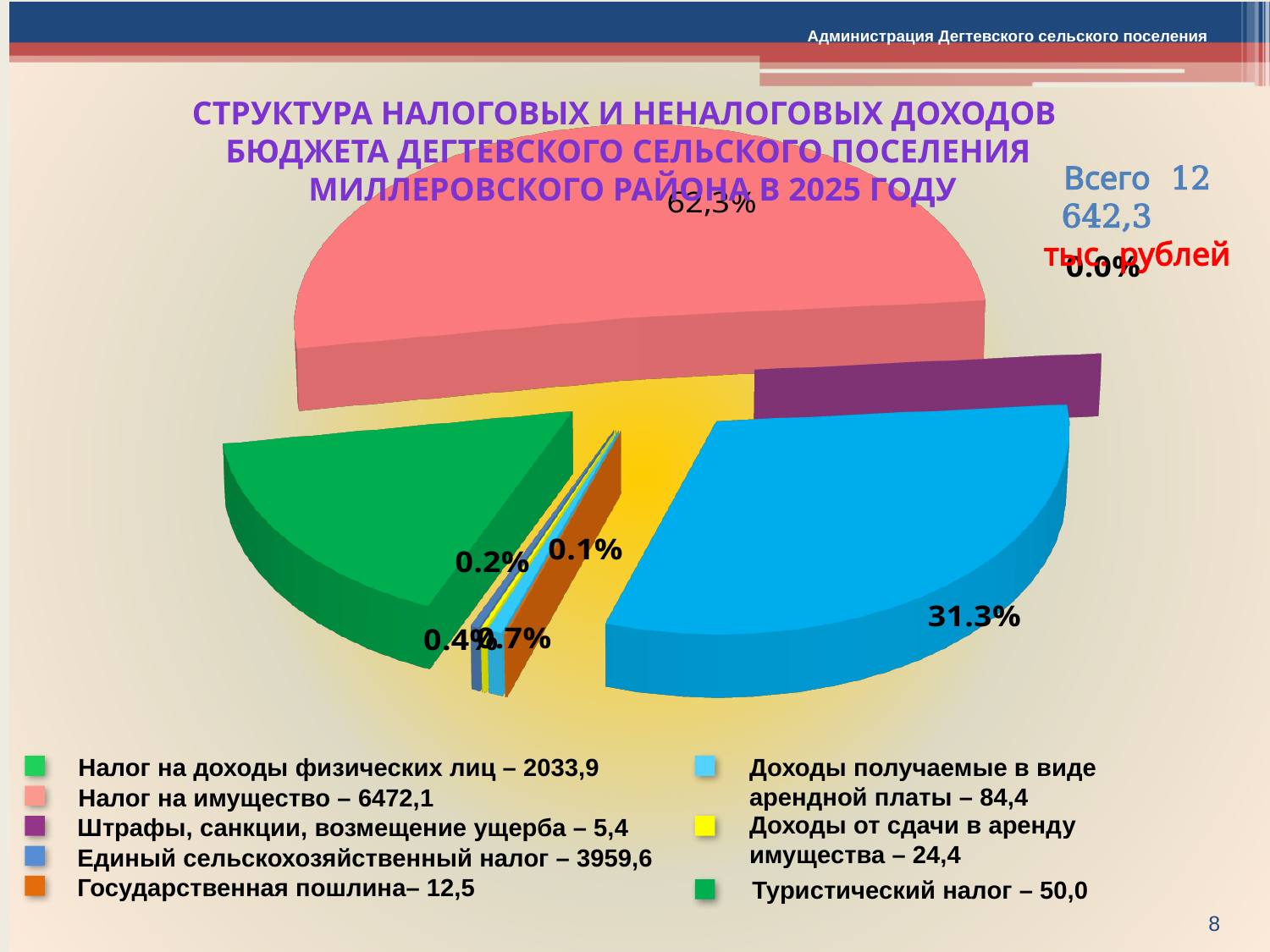
What value is given in the legend for 'Налог на имущество'? 6472,1 What percentage is printed next to the large blue slice of the pie chart? 31.3% Which legend category has the smallest value? Штрафы, санкции, возмещение ущерба Which is larger according to the legend: 'Налог на имущество' or 'Налог на доходы физических лиц'? Налог на имущество What kind of chart is shown on the slide? pie chart What is the difference between the legend values for 'Налог на имущество' (6472,1) and 'Единый сельскохозяйственный налог' (3959,6)? 2512,5 What value is given in the legend for 'Государственная пошлина'? 12,5 What percentage is printed on the largest (pink) slice of the pie chart? 62,3% How many revenue categories are listed in the legend below the pie chart? 8 What value is given in the legend for 'Единый сельскохозяйственный налог'? 3959,6 What is the total amount of revenues stated on the slide (Всего)? 12 642,3 тыс. рублей What value is given in the legend for 'Туристический налог'? 50,0